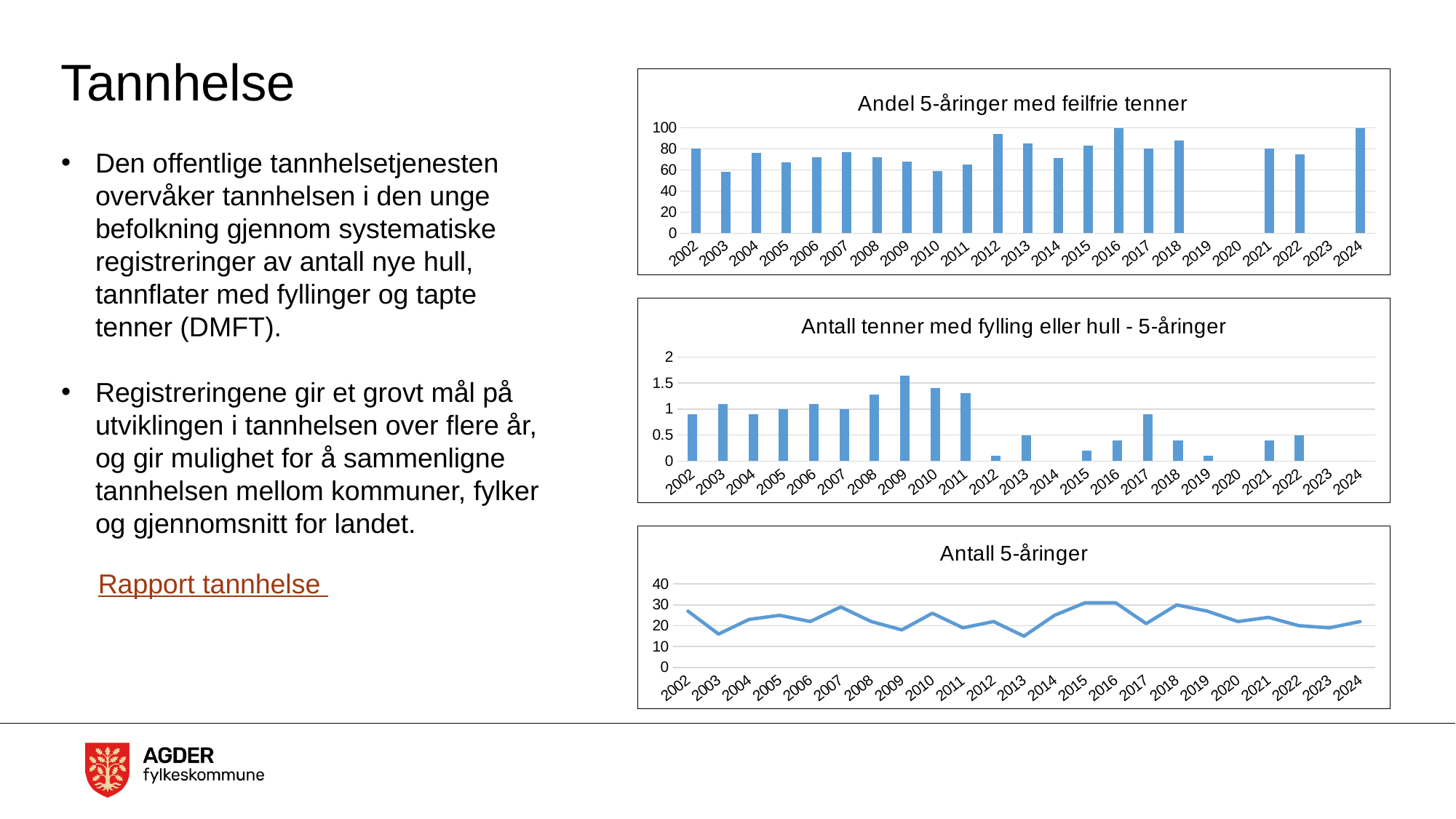
In the middle chart 'Antall tenner med fylling eller hull - 5-åringer', which is larger, the value for 2009 or the value for 2002? 2009 In the middle chart 'Antall tenner med fylling eller hull - 5-åringer', which year has the highest value? 2009 In the middle chart 'Antall tenner med fylling eller hull - 5-åringer', do the values generally rise or fall from 2011 to 2012? fall In the top chart 'Andel 5-åringer med feilfrie tenner', is the value for 2012 greater or less than 80? greater In the top chart 'Andel 5-åringer med feilfrie tenner', is the value for 2003 greater or less than 80? less How many years are shown on the x axis of the bottom chart 'Antall 5-åringer'? 23 In the middle chart 'Antall tenner med fylling eller hull - 5-åringer', is the value for 2015 greater or less than 0.5? less In the bottom chart 'Antall 5-åringer', which is larger, the value for 2002 or the value for 2003? 2002 What kind of chart is the bottom chart, 'Antall 5-åringer'? line chart What kind of chart is the top chart, 'Andel 5-åringer med feilfrie tenner'? bar chart